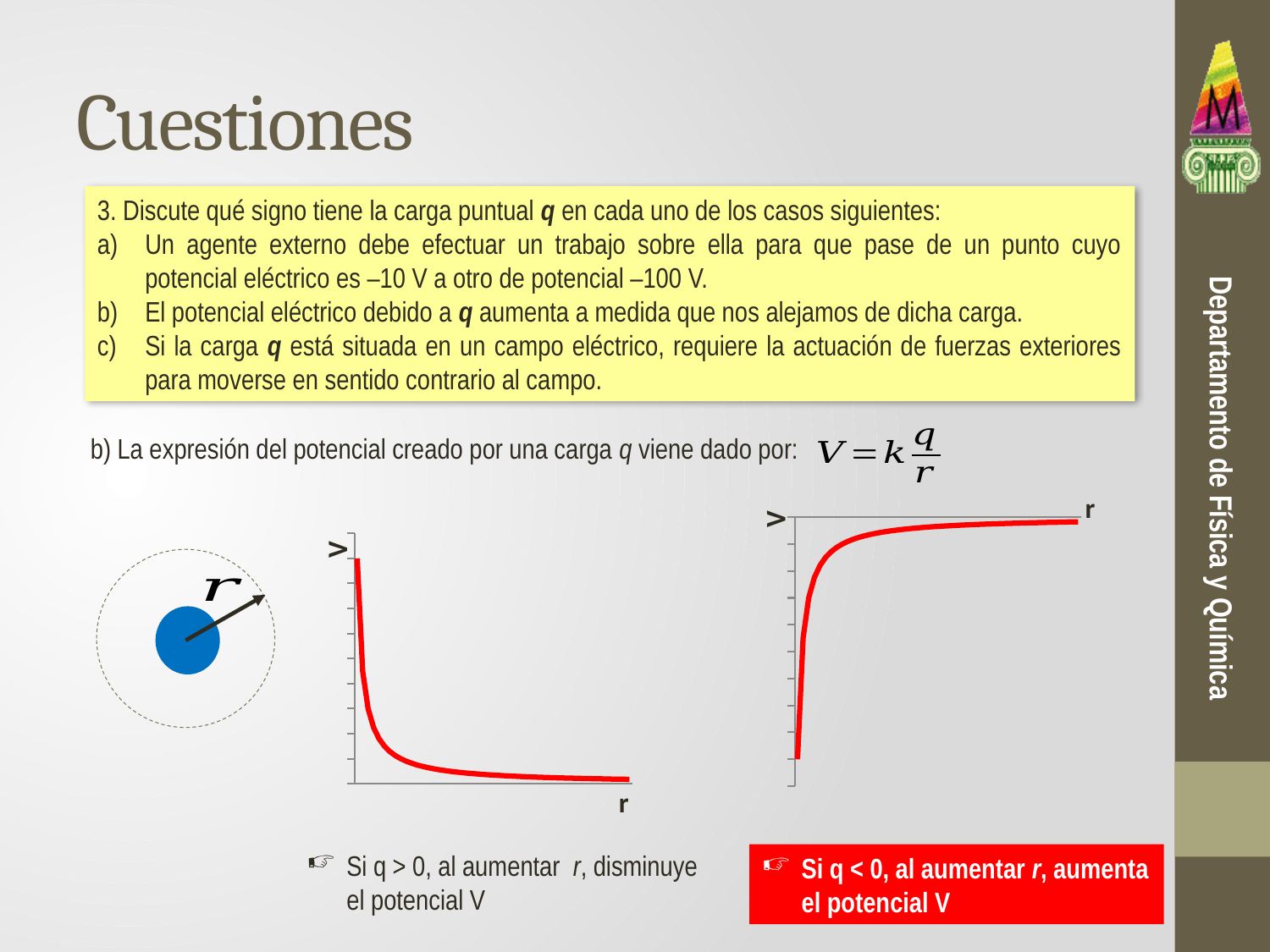
In the left graph (q > 0), does the potential V rise or fall as r increases? fall What colour is the curve plotted in the two graphs? red According to the slide, for which sign of q does the potential V decrease as r increases? q > 0 In the right graph (q < 0), does the potential V rise or fall as r increases? rise How many graphs of V versus r are shown on the slide? 2 What is the label on the horizontal axis of the left graph? r What kind of chart is the left graph on the slide? line chart What kind of chart is the right graph on the slide? line chart